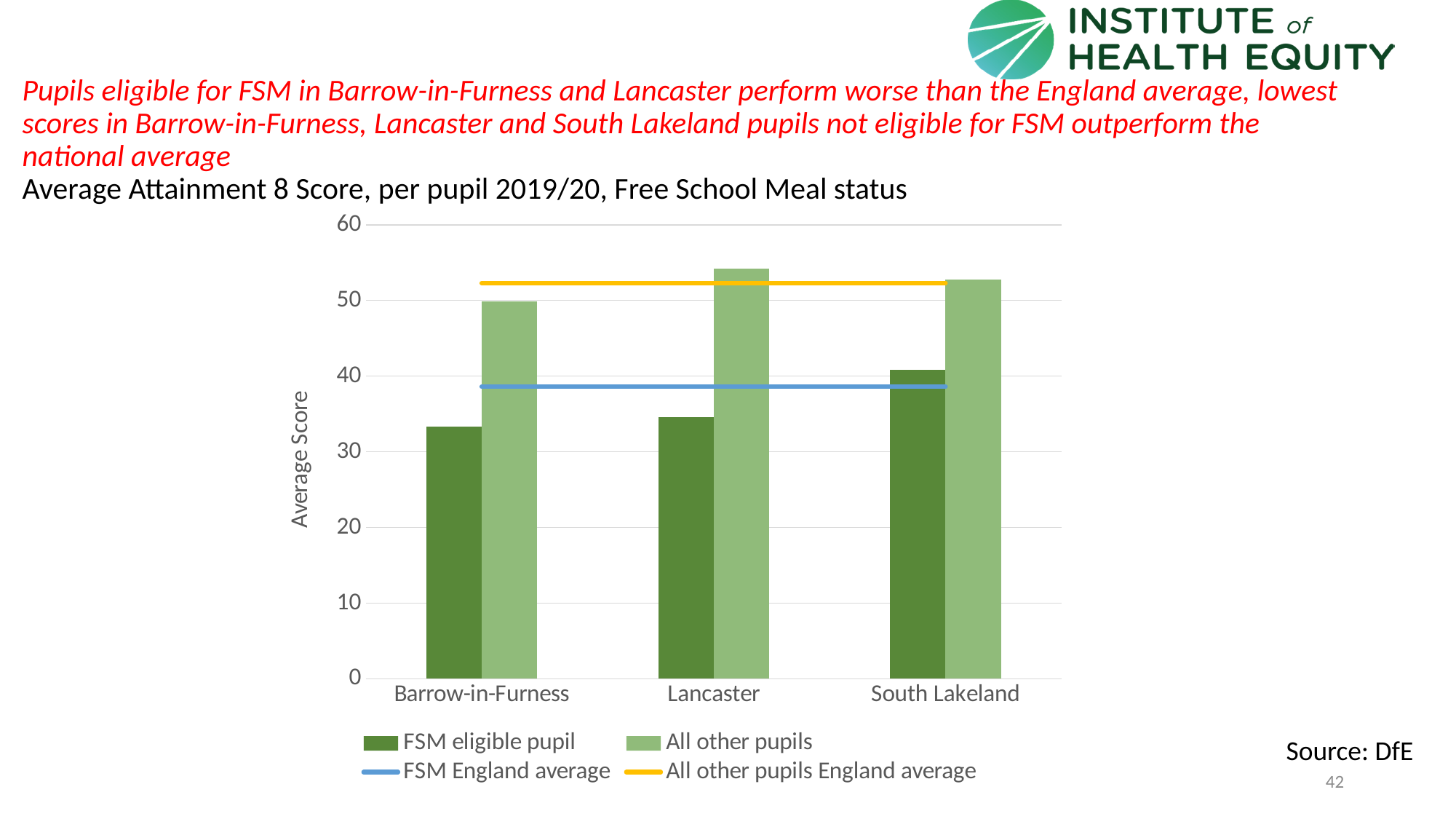
Is the Average Score for All other pupils in Barrow-in-Furness greater or less than 40? greater Which area has the lowest Average Score for All other pupils? Barrow-in-Furness How many entries does the chart's legend list? 4 What source is cited for the chart's data? DfE Is the Average Score for FSM eligible pupils in Barrow-in-Furness greater or less than 40? less What is the label on the chart's vertical axis? Average Score What kind of chart is shown on the slide? bar chart Which is larger: the FSM eligible pupil score in South Lakeland or the FSM eligible pupil score in Lancaster? South Lakeland Which area has the highest Average Score for FSM eligible pupils? South Lakeland Is the Average Score for All other pupils in Lancaster greater or less than 50? greater How many local areas are shown on the x axis of the chart? 3 In Barrow-in-Furness, which group has the higher Average Score: FSM eligible pupils or All other pupils? All other pupils